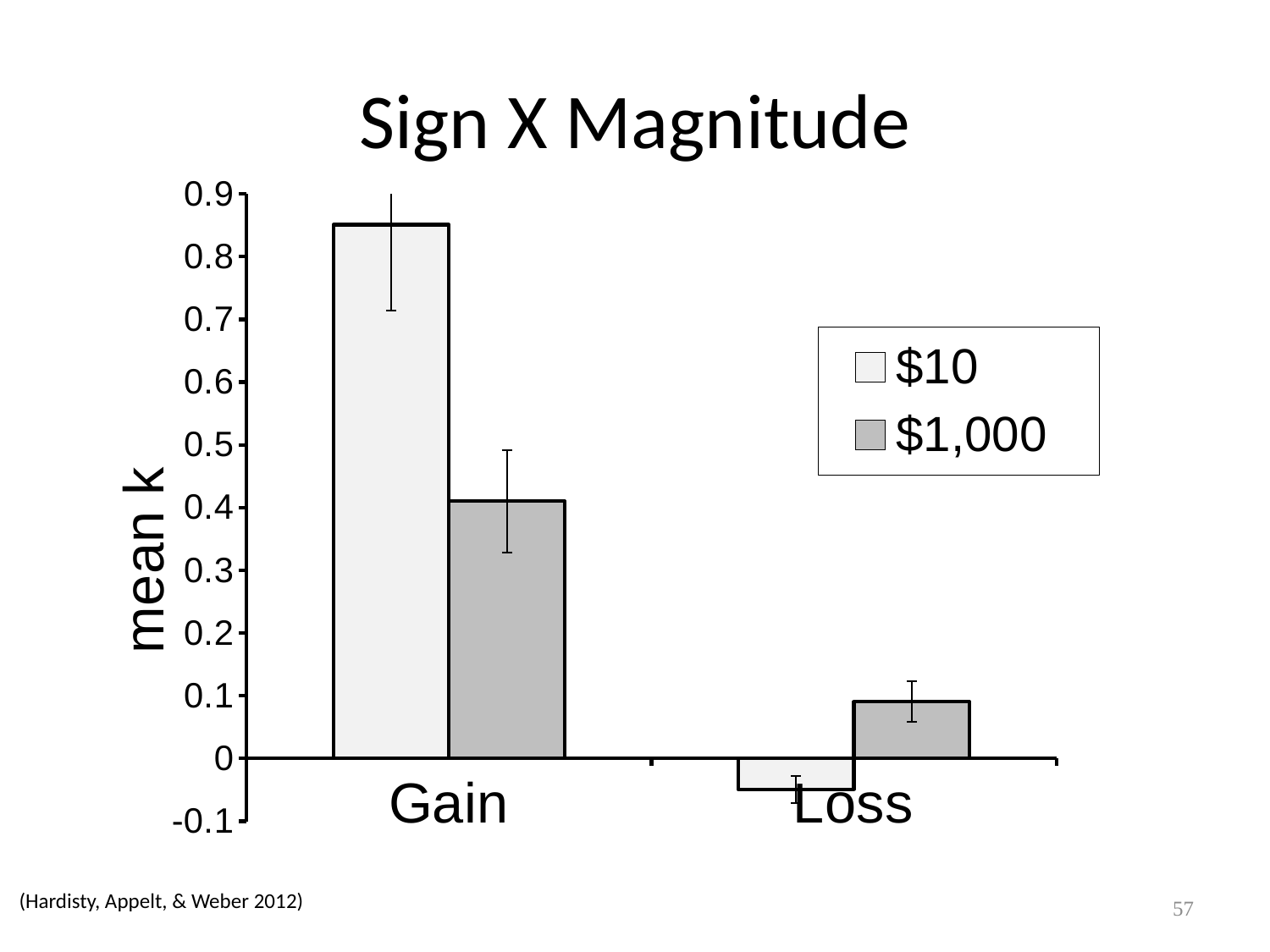
Is the mean k for $1,000 in the Gain condition greater or less than 0.5? less What is the label of the y axis? mean k Which bar has the lowest mean k? $10 in Loss Is the mean k for $10 in the Gain condition greater or less than 0.8? greater Is the mean k for $10 in the Loss condition greater or less than 0? less Which bar has the highest mean k? $10 in Gain How many categories are shown on the x axis? 2 In the Loss condition, which is larger: the mean k for $10 or for $1,000? $1,000 What kind of chart is shown on the slide? bar chart In the Gain condition, which is larger: the mean k for $10 or for $1,000? $10 How many series does the legend list? 2 What is the title of the chart? Sign X Magnitude